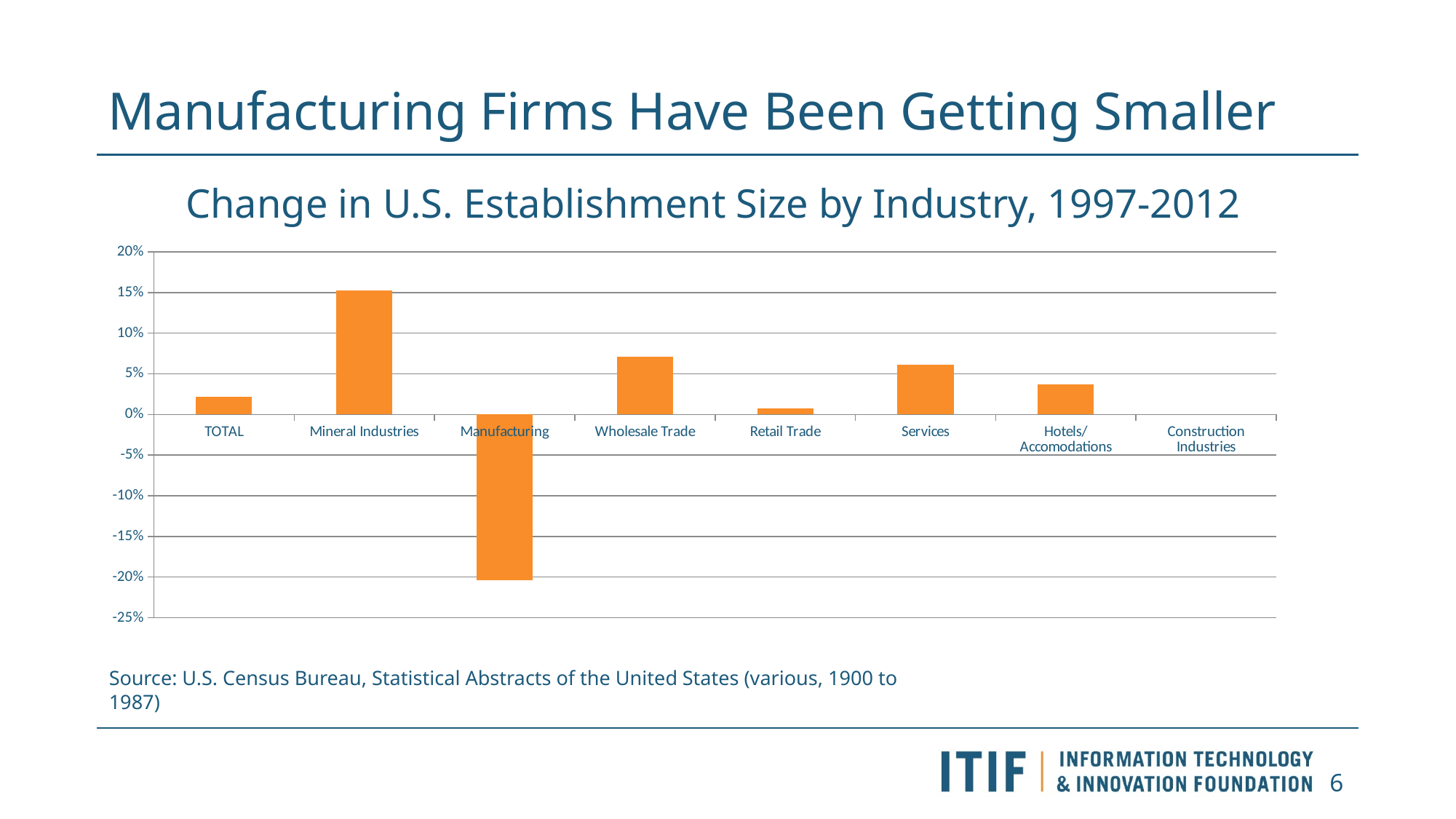
What kind of chart is shown on the slide? Bar chart What is the title of the chart? Change in U.S. Establishment Size by Industry, 1997-2012 How many industry categories are shown on the x axis of the chart? 8 How many categories in the chart have a negative value? 1 Is the value for Wholesale Trade greater or less than 5%? greater Which is larger, the value for Services or the value for Hotels/Accomodations? Services Is the value for Mineral Industries greater or less than 10%? greater Is the value for Manufacturing greater or less than -15%? less Which category has the highest value in the chart? Mineral Industries Which is larger, the value for Mineral Industries or the value for Wholesale Trade? Mineral Industries Which category has the lowest value in the chart? Manufacturing